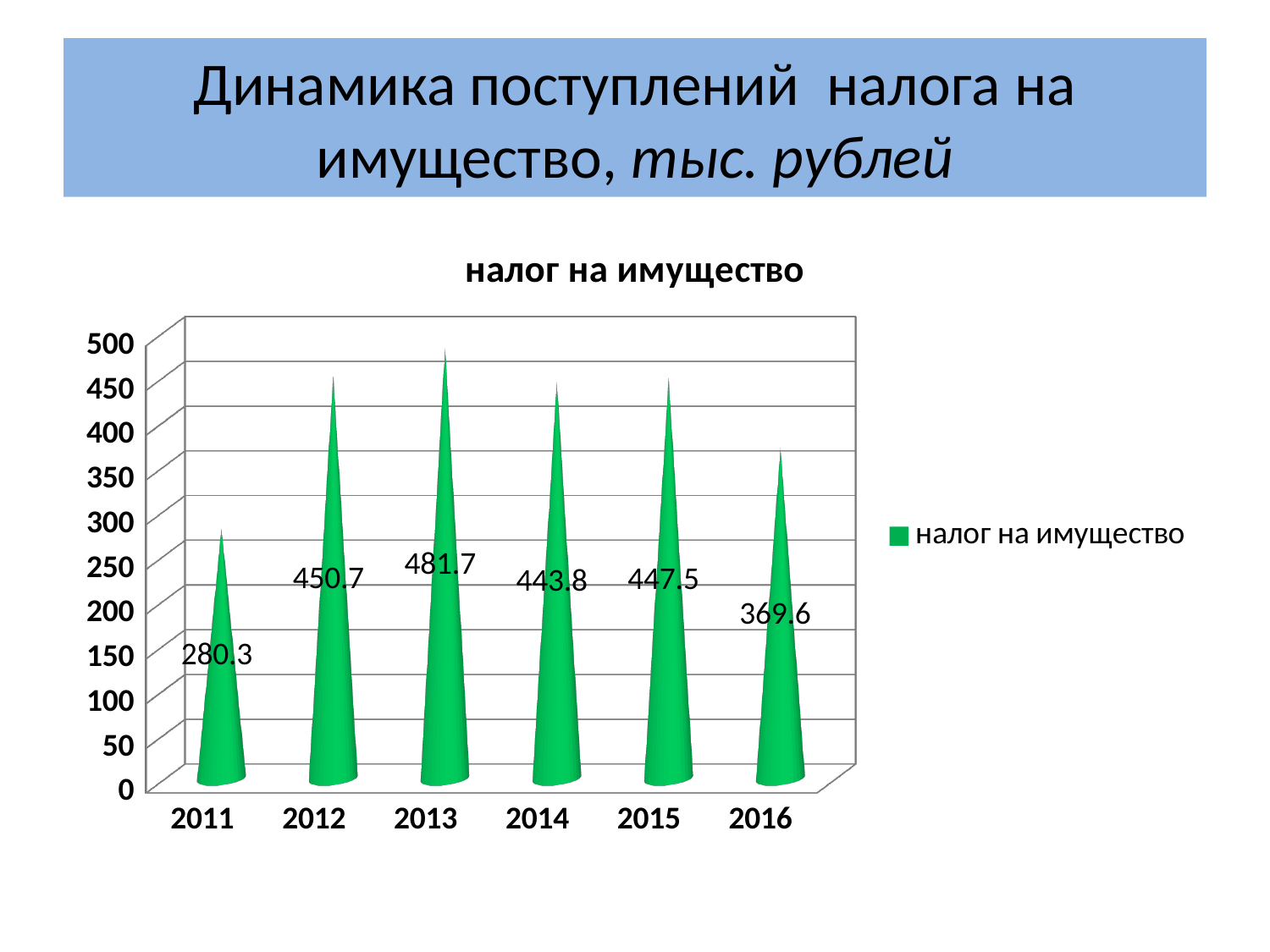
What is the value for 2013 in the chart? 481.7 What is the value for 2016 in the chart? 369.6 Do the values rise or fall from 2011 to 2013? rise What is the difference between the values for 2012 and 2016? 81.1 Which is larger, the value for 2012 or the value for 2016? 2012 What is the value for 2015 in the chart? 447.5 What is the difference between the values for 2013 and 2011? 201.4 What is the value for 2011 in the chart? 280.3 Which year has the lowest value in the chart? 2011 Which year has the highest value in the chart? 2013 How many series does the legend list? 1 How many years are shown on the x axis of the chart? 6